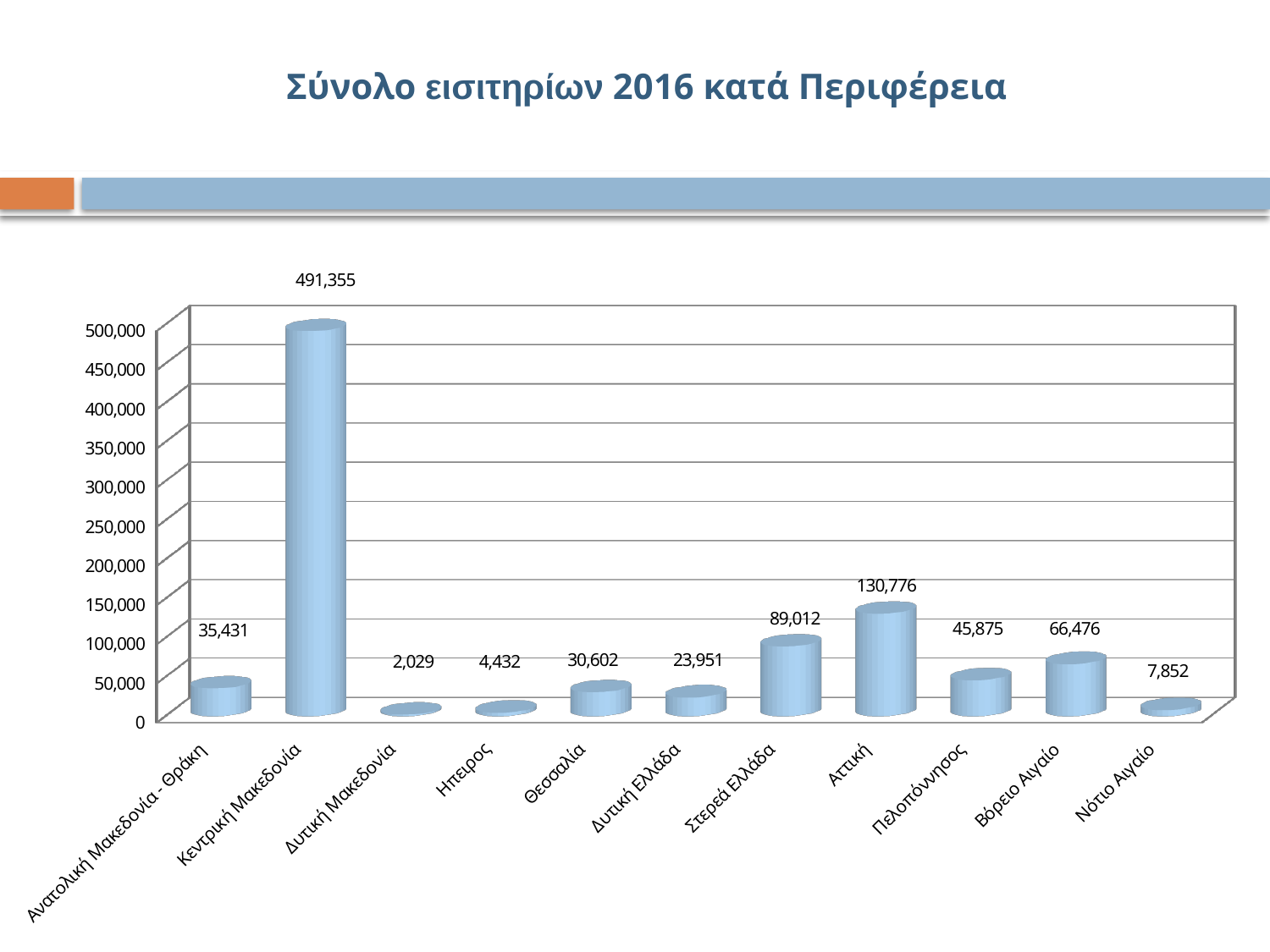
Which is larger, the value for Βόρειο Αιγαίο or the value for Πελοπόννησος? Βόρειο Αιγαίο What is the value for Αττική? 130,776 What kind of chart is shown on the slide? bar chart What is the value for Νότιο Αιγαίο? 7,852 What is the value for Κεντρική Μακεδονία? 491,355 How many regions are shown on the x axis? 11 What is the difference between the values for Αττική and Στερεά Ελλάδα? 41,764 Which region has the lowest value? Δυτική Μακεδονία Is the value for Στερεά Ελλάδα greater or less than 100,000? less Which region has the highest value? Κεντρική Μακεδονία What is the title of the chart? Σύνολο εισιτηρίων 2016 κατά Περιφέρεια What is the difference between the values for Ήπειρος and Δυτική Μακεδονία? 2,403